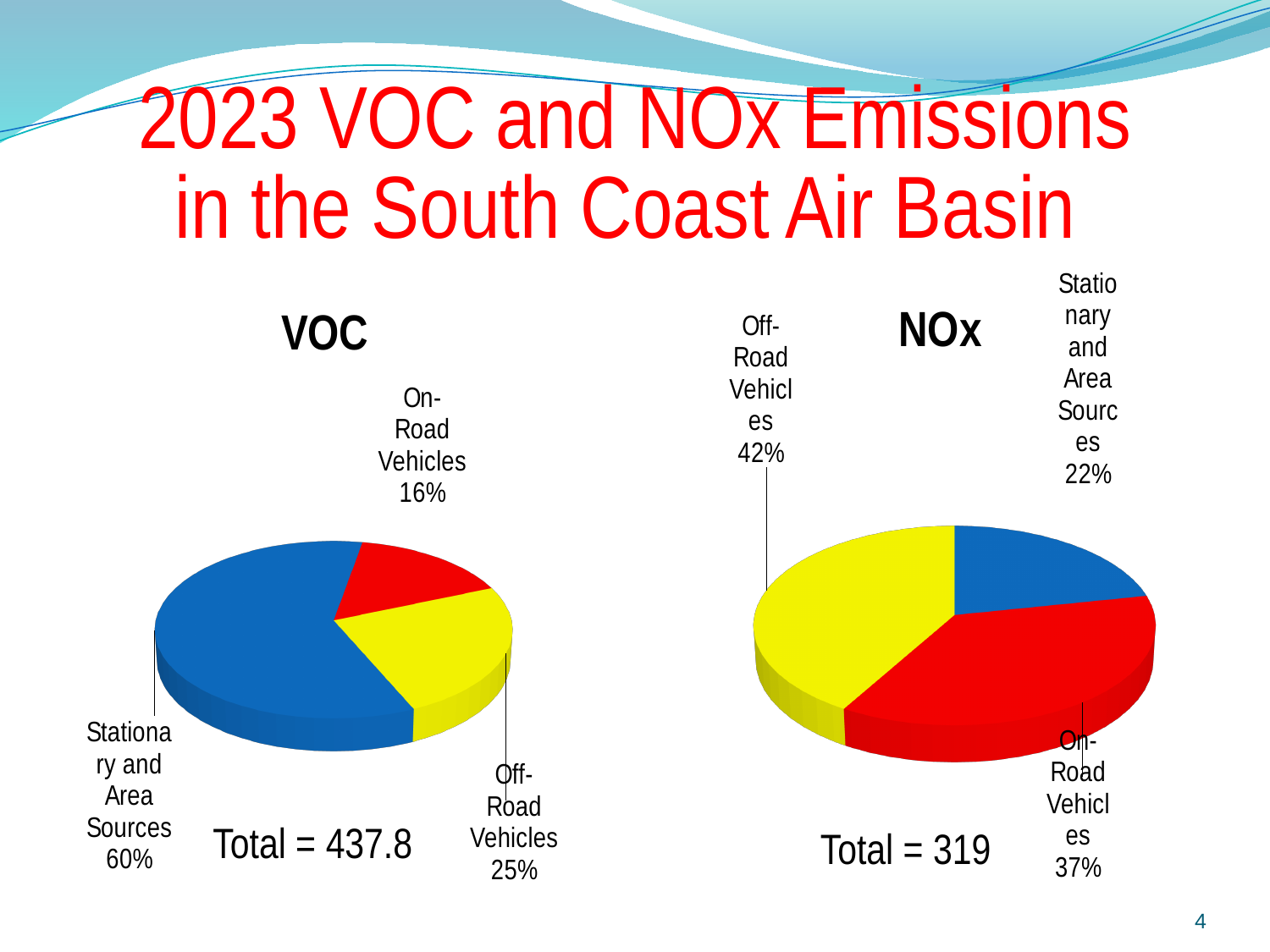
In the VOC chart, which is larger: the share for Off-Road Vehicles or the share for On-Road Vehicles? Off-Road Vehicles In the NOx chart, what is the difference in percentage points between Off-Road Vehicles and Stationary and Area Sources? 20 percentage points In the VOC chart, what share of emissions comes from Off-Road Vehicles? 25% In the NOx chart, what share of emissions comes from Off-Road Vehicles? 42% In the NOx chart, what share of emissions comes from Stationary and Area Sources? 22% What kind of chart is used for the NOx emissions? Pie chart In the VOC chart, which source category has the largest share? Stationary and Area Sources What total is shown below the VOC chart? Total = 437.8 In the NOx chart, which source category has the smallest share? Stationary and Area Sources